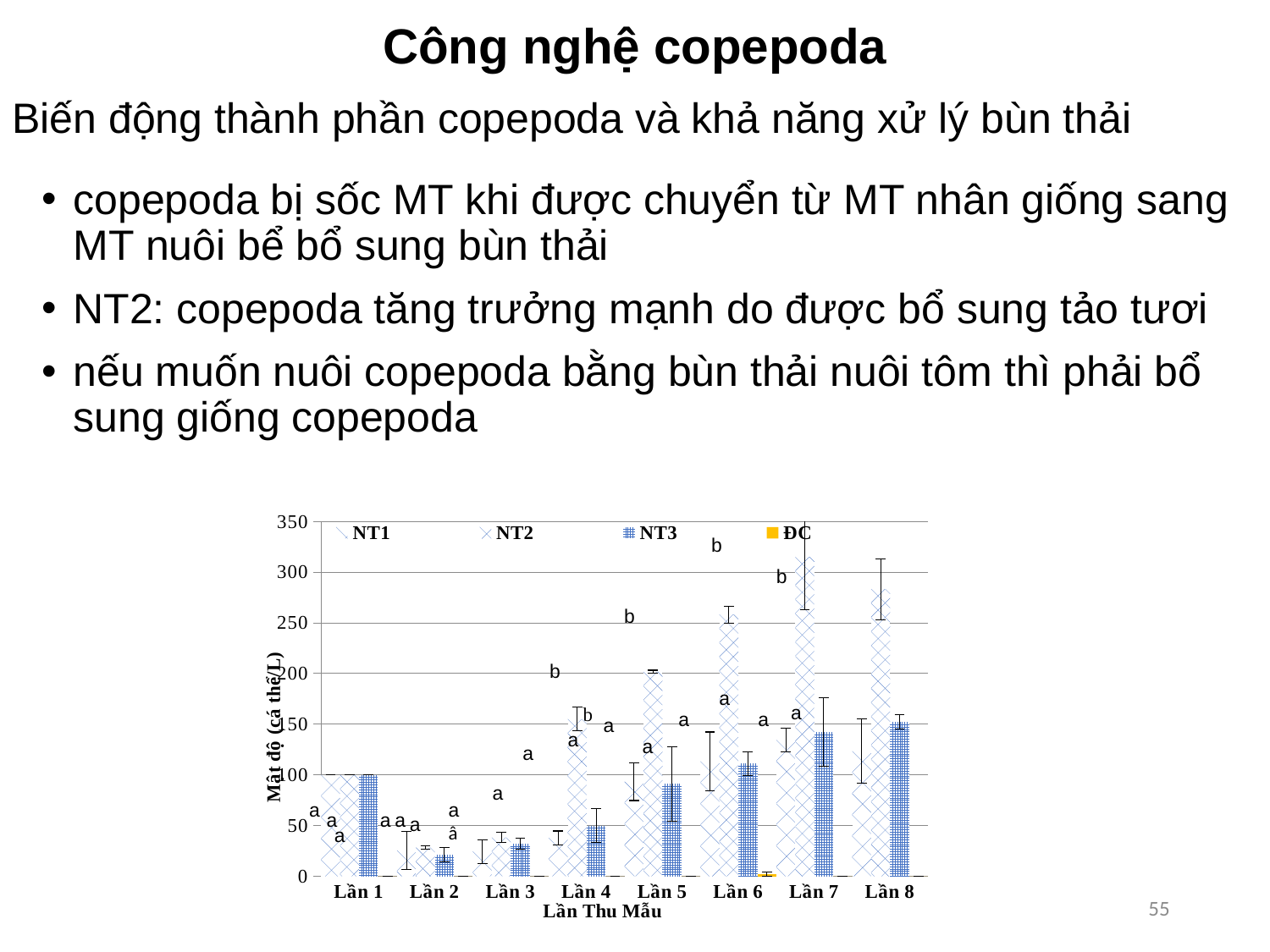
What is the title of the y axis of the chart? Mật độ (cá thể/L) Which is larger at Lần 5: NT2 or NT3? NT2 Is the value for NT2 at Lần 7 greater or less than 300? greater Which series has the highest bar in the chart? NT2 Which is larger at Lần 4: NT2 or NT1? NT2 At which sampling time does NT2 reach its highest value? Lần 7 How many sampling categories (Lần) are shown on the x axis? 8 Do the NT2 values rise or fall from Lần 3 to Lần 7? rise What kind of chart is shown on the slide? bar chart Is the value for NT2 at Lần 6 greater or less than 250? greater How many series does the chart legend list? 4 Is the value for NT3 at Lần 2 greater or less than 50? less